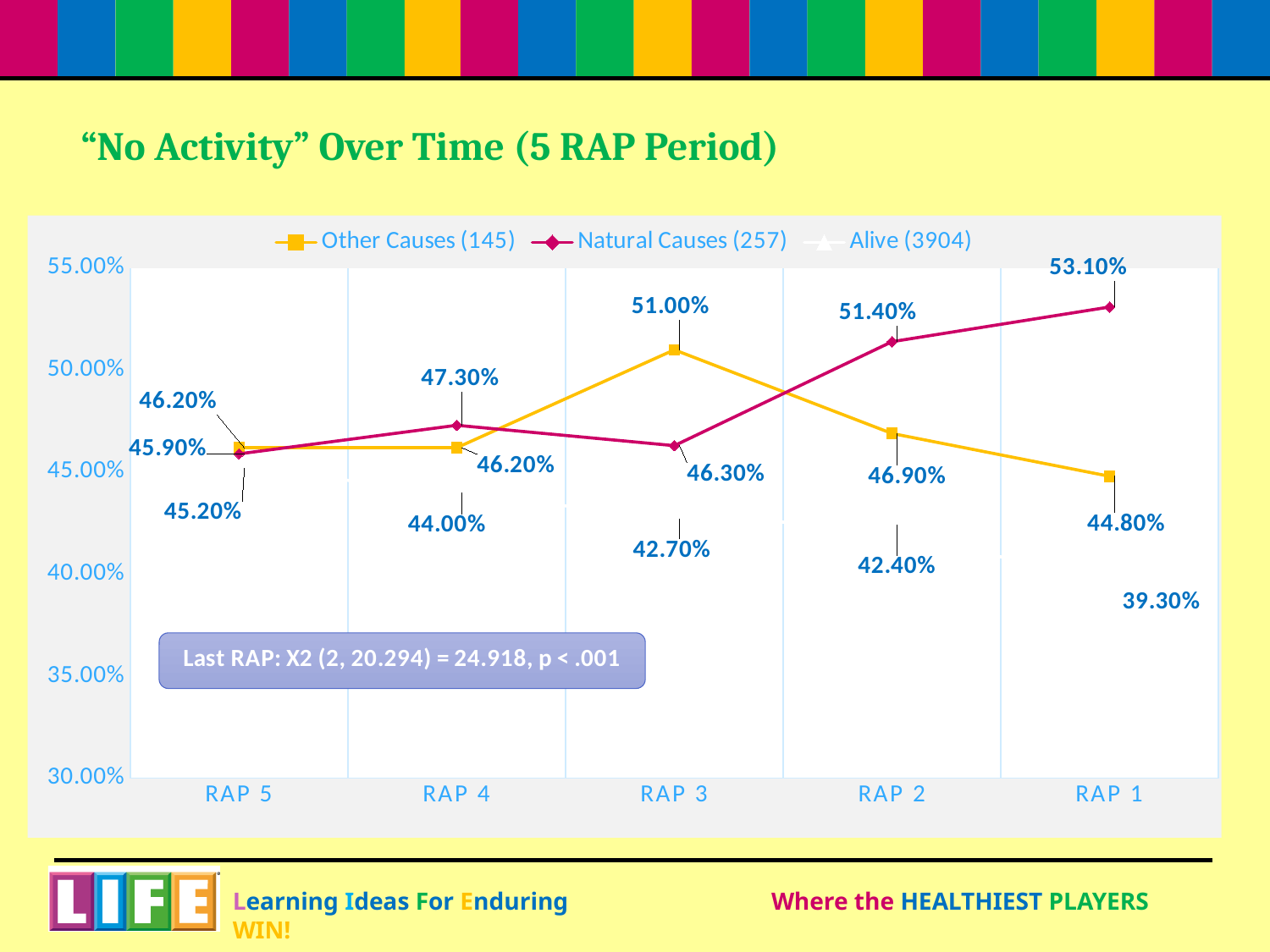
At which RAP period is the Other Causes series highest? RAP 3 What is the value for Natural Causes at RAP 1? 53.10% How many series does the legend list? 3 How many RAP periods are shown on the x axis? 5 What count is shown in the legend for the Alive series? 3904 What is the difference between Natural Causes and Other Causes at RAP 1? 8.30 percentage points What is the value for Other Causes at RAP 5? 46.20% What kind of chart is shown on the slide? Line chart At which RAP period is the Other Causes series lowest? RAP 1 At RAP 2, which series has the higher value, Natural Causes or Other Causes? Natural Causes What is the value for Other Causes at RAP 3? 51.00% At which RAP period is the Natural Causes series highest? RAP 1